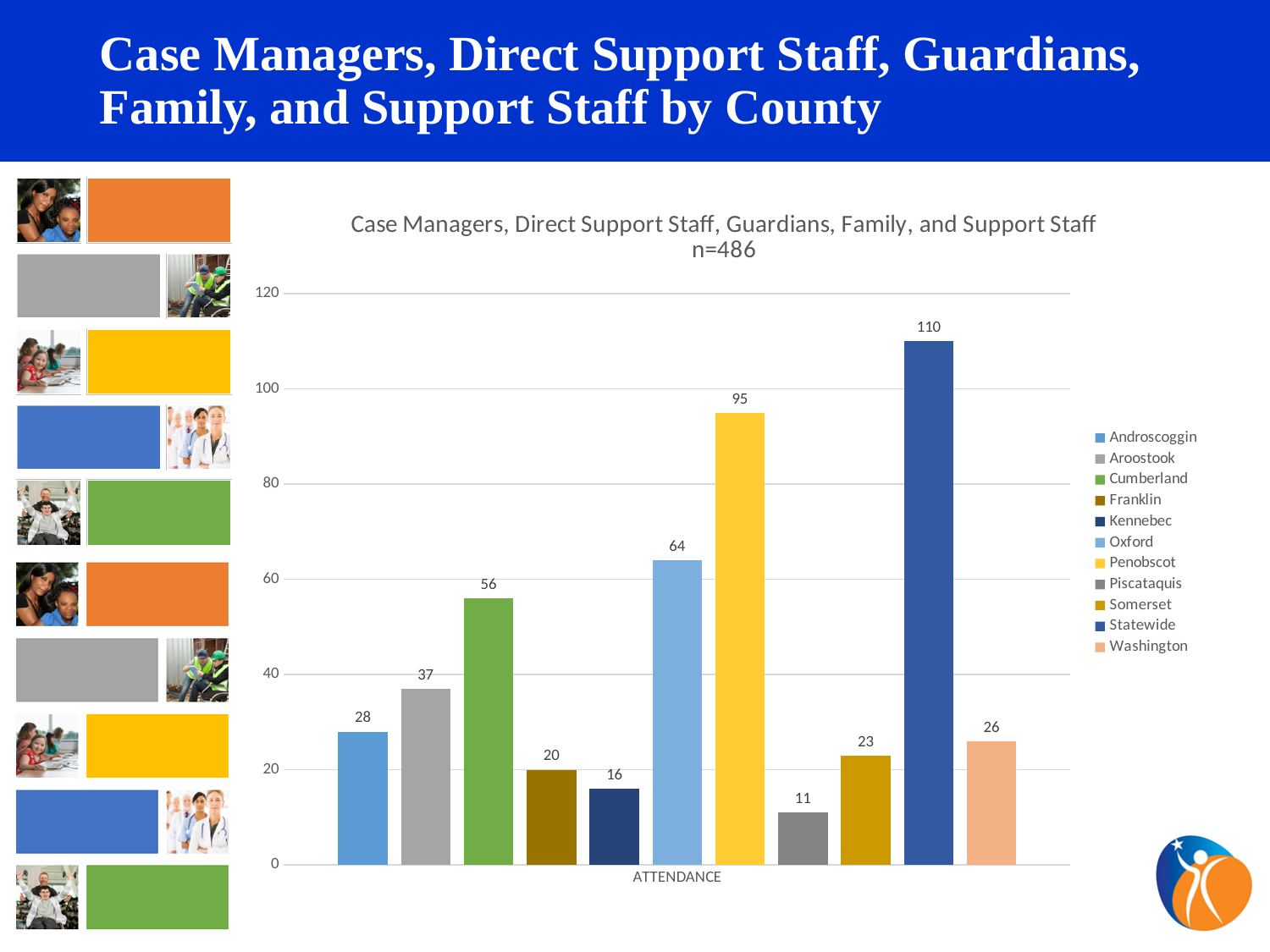
What is the attendance value for Penobscot? 95 What is the difference between the Oxford value and the Aroostook value? 27 How many series does the legend list? 11 What is the attendance value for Cumberland? 56 What is the difference between the Statewide value and the Penobscot value? 15 What is the n value shown in the chart title? n=486 Is the value for Somerset greater or less than 20? greater Which is larger, the value for Androscoggin or the value for Washington? Androscoggin What kind of chart is shown on the slide? Bar chart What is the attendance value for Kennebec? 16 Which legend entry has the highest bar? Statewide Which legend entry has the lowest bar? Piscataquis